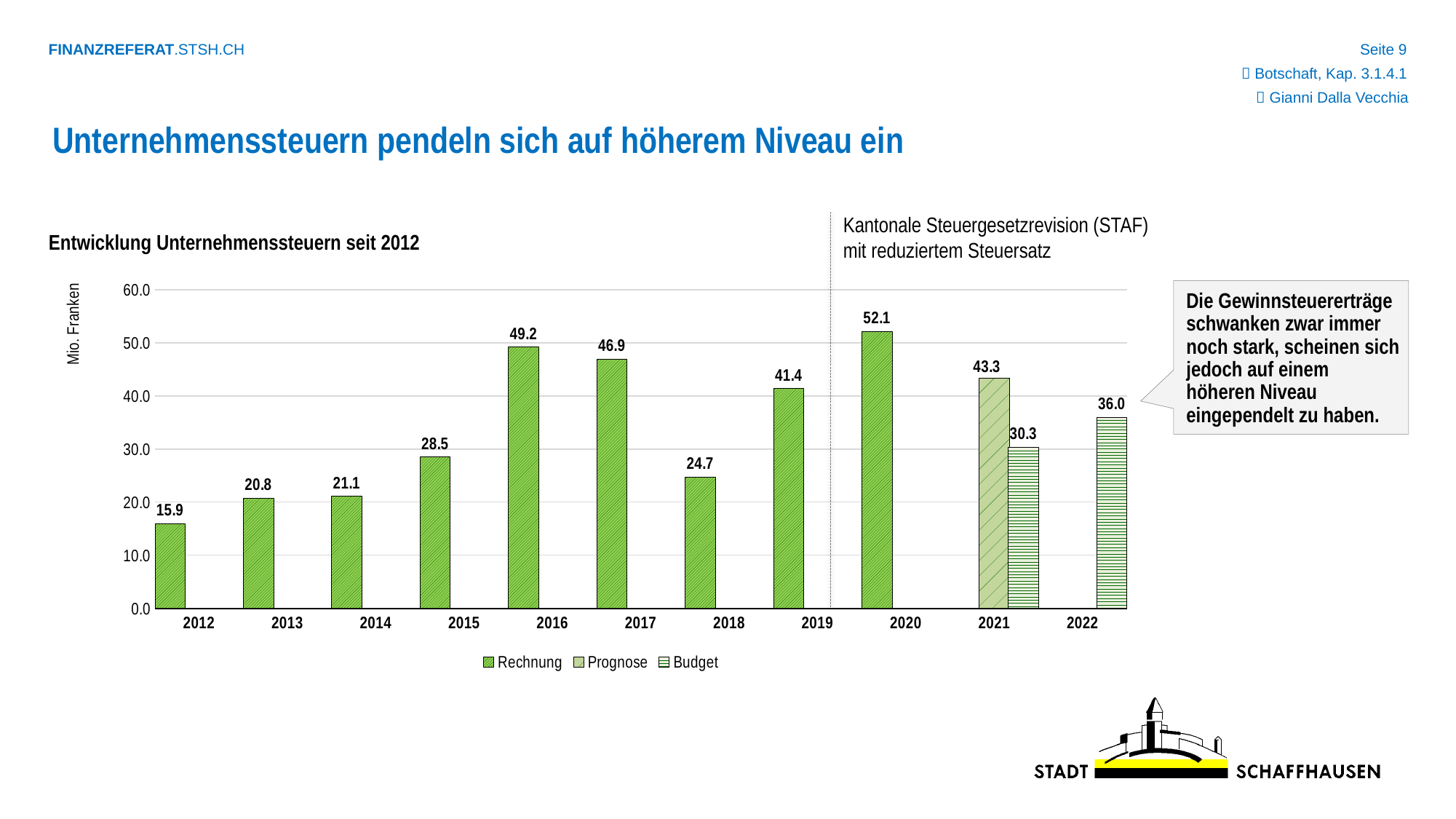
What unit is shown on the y axis of the chart? Mio. Franken What is the Prognose value for 2021? 43.3 Which is larger, the Rechnung value for 2016 or for 2017? 2016 What is the Budget value for 2022? 36.0 How many years are shown on the x axis? 11 How many series does the legend list? 3 What is the difference between the Prognose and Budget values for 2021? 13.0 What kind of chart is shown on the slide? bar chart What is the difference between the Rechnung values for 2020 and 2019? 10.7 Which year has the highest Rechnung value? 2020 Which year has the lowest Rechnung value? 2012 What is the Rechnung value for 2016? 49.2